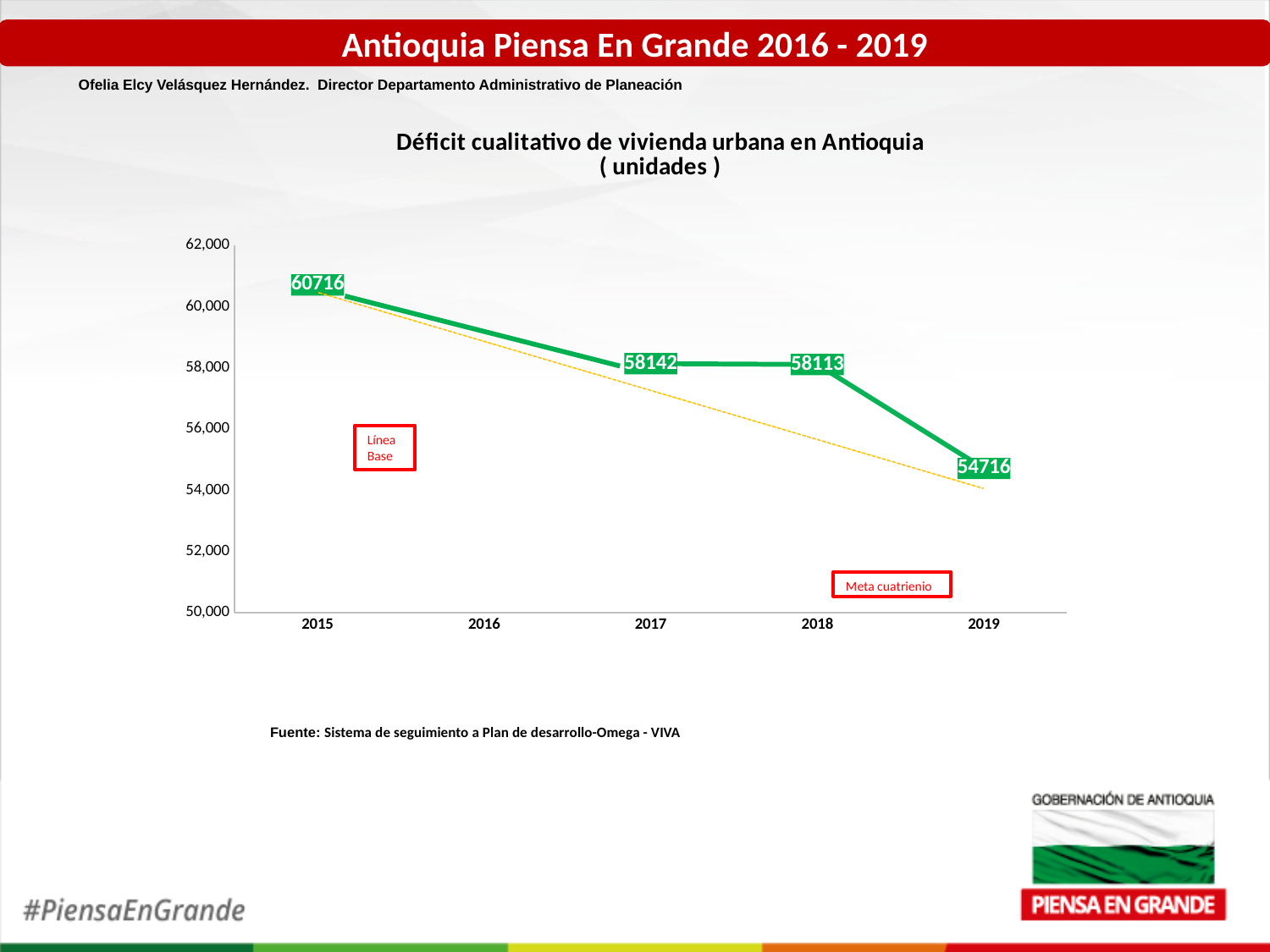
What is the value for 2018 in the chart? 58113 What is the difference between the values for 2015 and 2019? 6000 Do the values rise or fall from 2015 to 2019? fall Which year has the lowest value in the chart? 2019 What is the value for 2019 in the chart? 54716 What is the difference between the values for 2017 and 2018? 29 What is the value for 2017 in the chart? 58142 Which year has the highest value in the chart? 2015 What is the value for 2015 in the chart? 60716 Which year has the larger value, 2017 or 2018? 2017 What kind of chart is shown on the slide? line chart